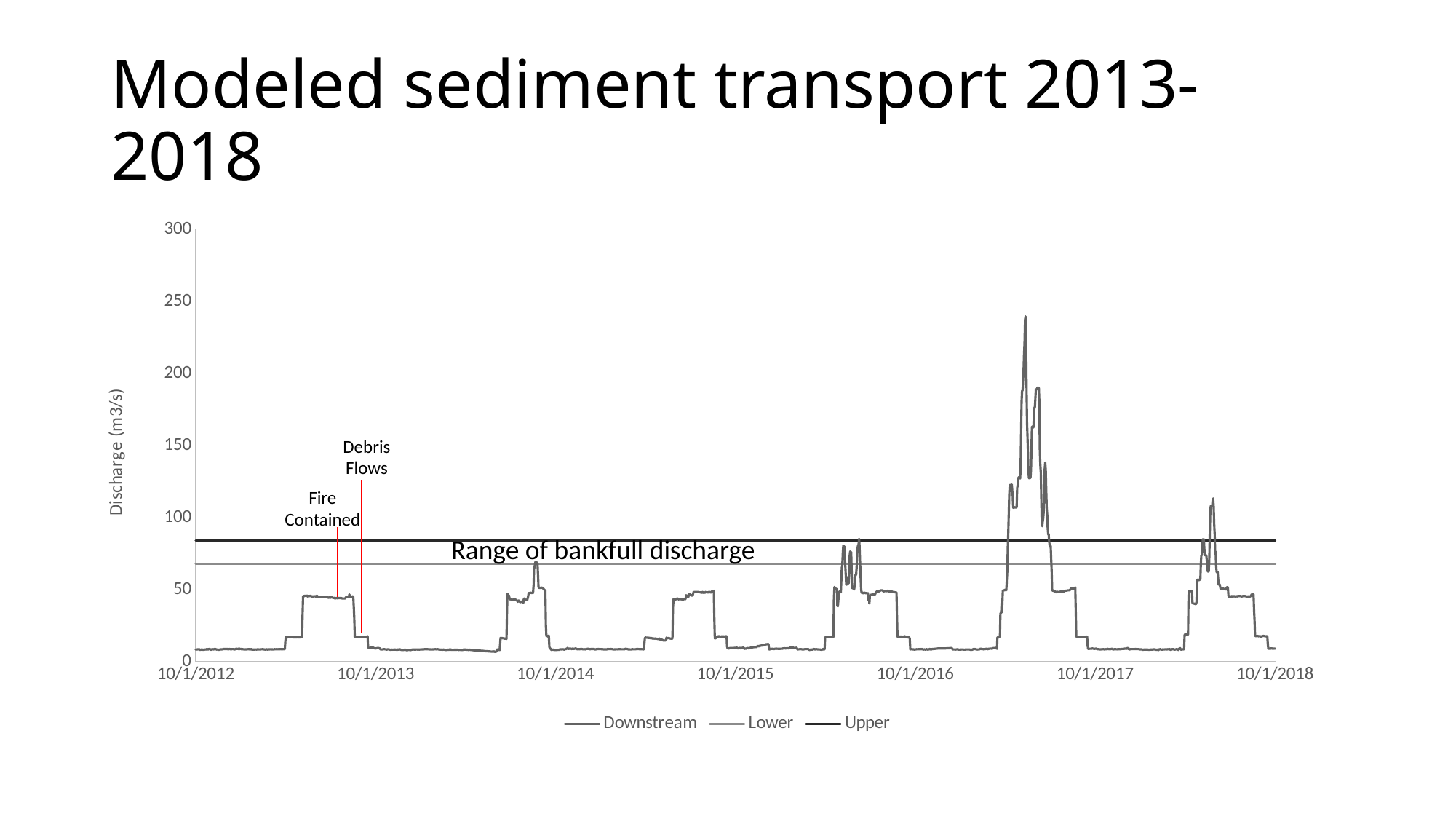
What is the label on the y-axis? Discharge (m3/s) Which is larger, the Downstream peak between 10/1/2016 and 10/1/2017 or the Downstream peak between 10/1/2017 and 10/1/2018? The peak between 10/1/2016 and 10/1/2017 Is the Lower line greater or less than 50? greater How many series does the legend list? 3 Is the Downstream value at 10/1/2012 greater or less than 50? less Is the highest value of the Downstream series greater or less than 200? greater What are the three series named in the legend? Downstream, Lower, Upper How many date ticks are labeled on the x-axis? 7 Between which two x-axis ticks does the Downstream series reach its highest peak? 10/1/2016 and 10/1/2017 What kind of chart is shown on the slide? Line chart